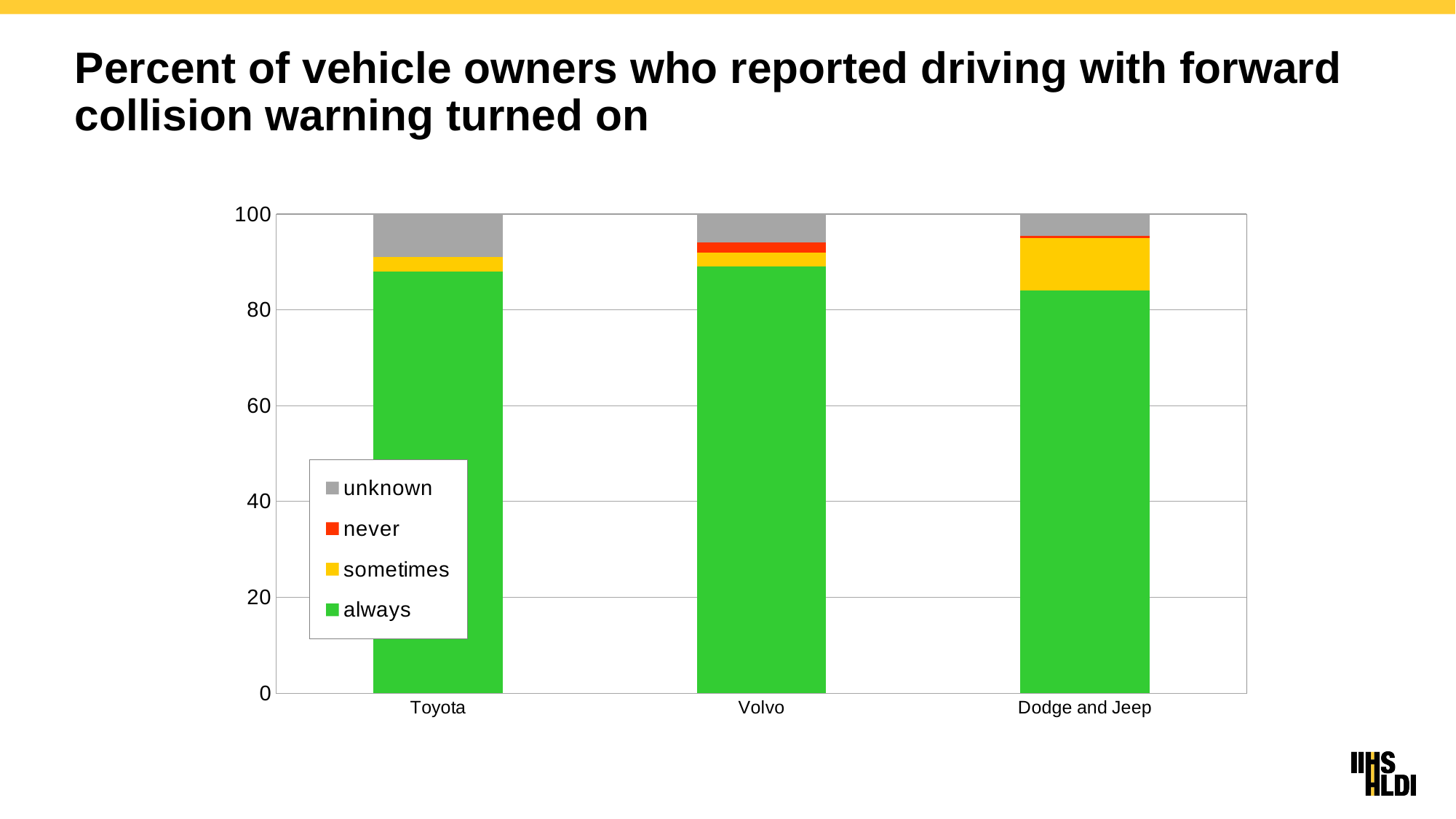
Is the 'sometimes' value for Dodge and Jeep greater or less than 20? less Which category has the largest 'unknown' segment? Toyota What is the title of the chart on the slide? Percent of vehicle owners who reported driving with forward collision warning turned on How many series does the legend list? 4 What is the total height of the stacked bar for Toyota? 100 Which category has the largest 'sometimes' segment? Dodge and Jeep What kind of chart is shown on the slide? stacked bar chart Is the 'always' value for Dodge and Jeep greater or less than 80? greater Which category has the smallest 'always' segment? Dodge and Jeep How many vehicle brand categories are shown on the x axis? 3 Is the 'always' value for Toyota greater or less than 80? greater Which colour represents the 'never' series in the legend? red